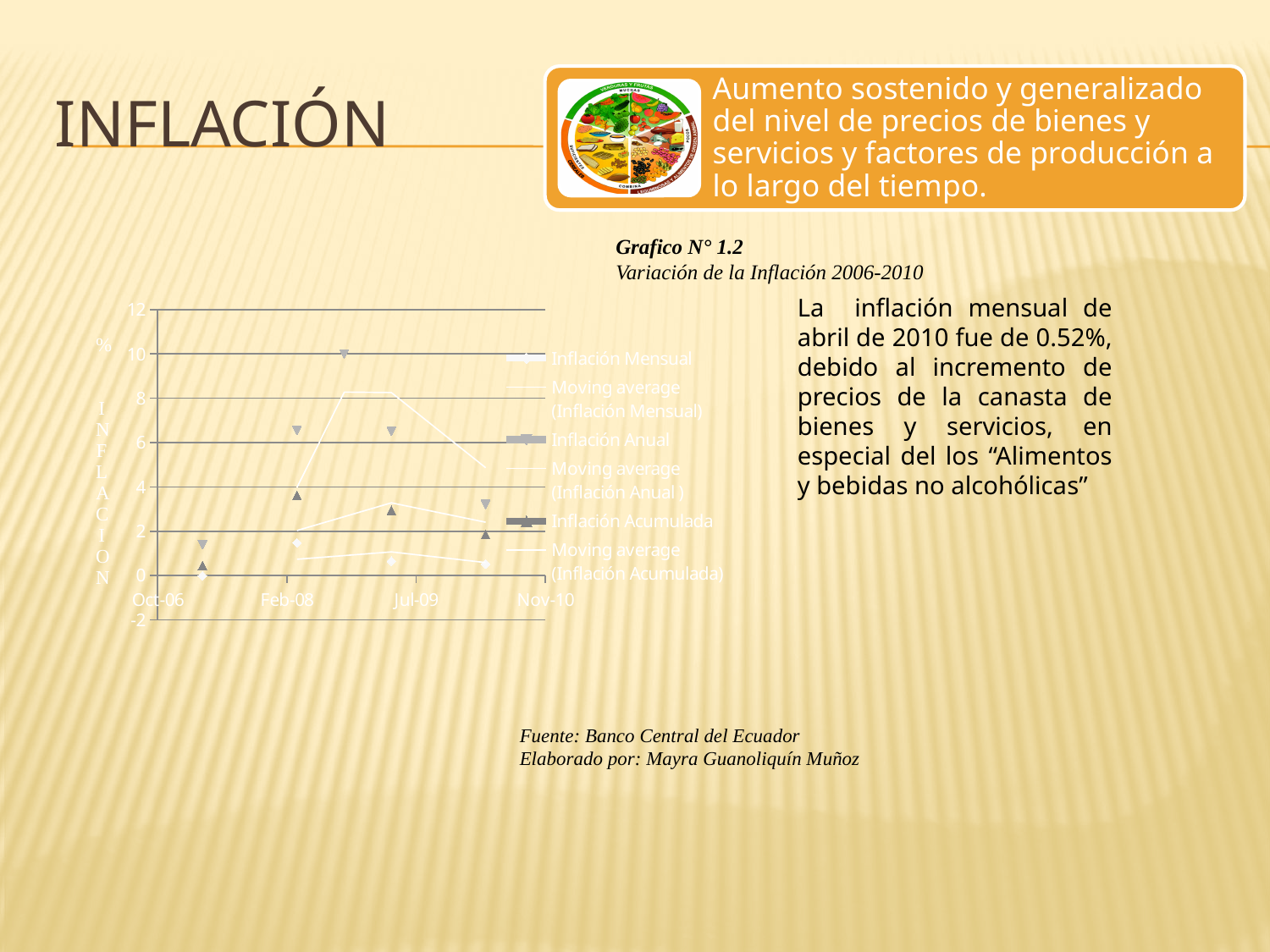
Which series reaches the highest value on the chart? Inflación Anual Does the Inflación Anual series rise or fall between its peak and the last point near Nov-10? fall Is the first plotted value of the Inflación Anual series (near Oct-06) greater or less than 2? less What is the title of the chart on the slide? Grafico N° 1.2 Variación de la Inflación 2006-2010 What is the first date label on the x axis? Oct-06 Which series stays lowest across the chart, Inflación Mensual or Inflación Anual? Inflación Mensual How many entries does the chart legend list? 6 Is the highest value of the Inflación Acumulada series greater or less than 6? less What kind of chart is shown on the slide? line chart How many date labels are shown on the x axis? 4 What is the maximum value shown on the y axis? 12 Is the peak value of the Inflación Anual series greater or less than 8? greater